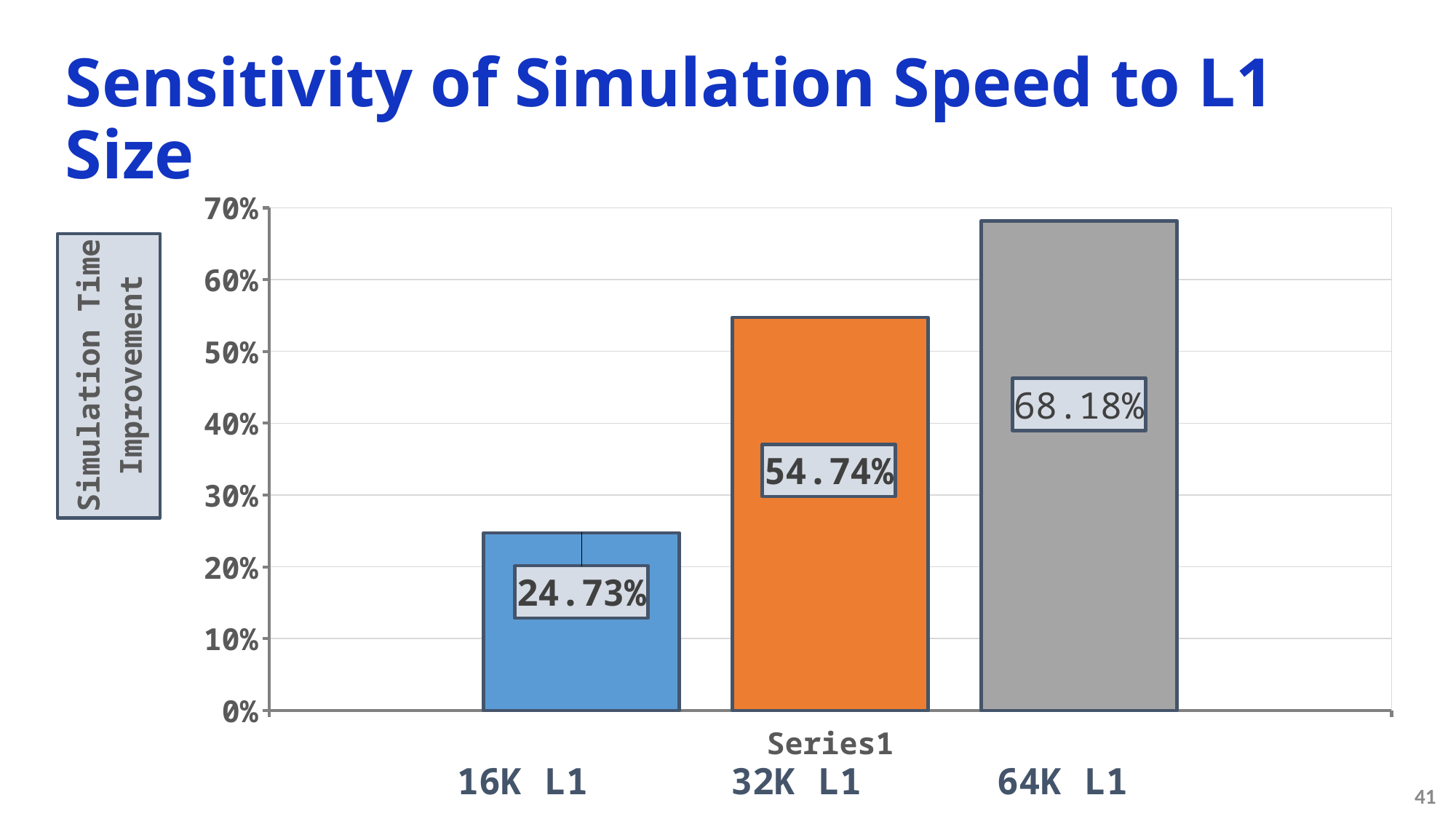
What is the simulation time improvement for 32K L1? 54.74% What is the difference in simulation time improvement between 32K L1 and 16K L1? 30.01% How many L1 sizes are plotted in the chart? 3 What is the difference in simulation time improvement between 64K L1 and 16K L1? 43.45% Do the values rise or fall as L1 size increases from 16K to 64K? Rise What is the simulation time improvement for 16K L1? 24.73% What is the simulation time improvement for 64K L1? 68.18% What kind of chart is shown on the slide? Bar chart Which L1 size has the highest simulation time improvement? 64K L1 Which L1 size has the lowest simulation time improvement? 16K L1 Is the value for 32K L1 greater or less than 50%? greater Which has a larger simulation time improvement, 32K L1 or 64K L1? 64K L1